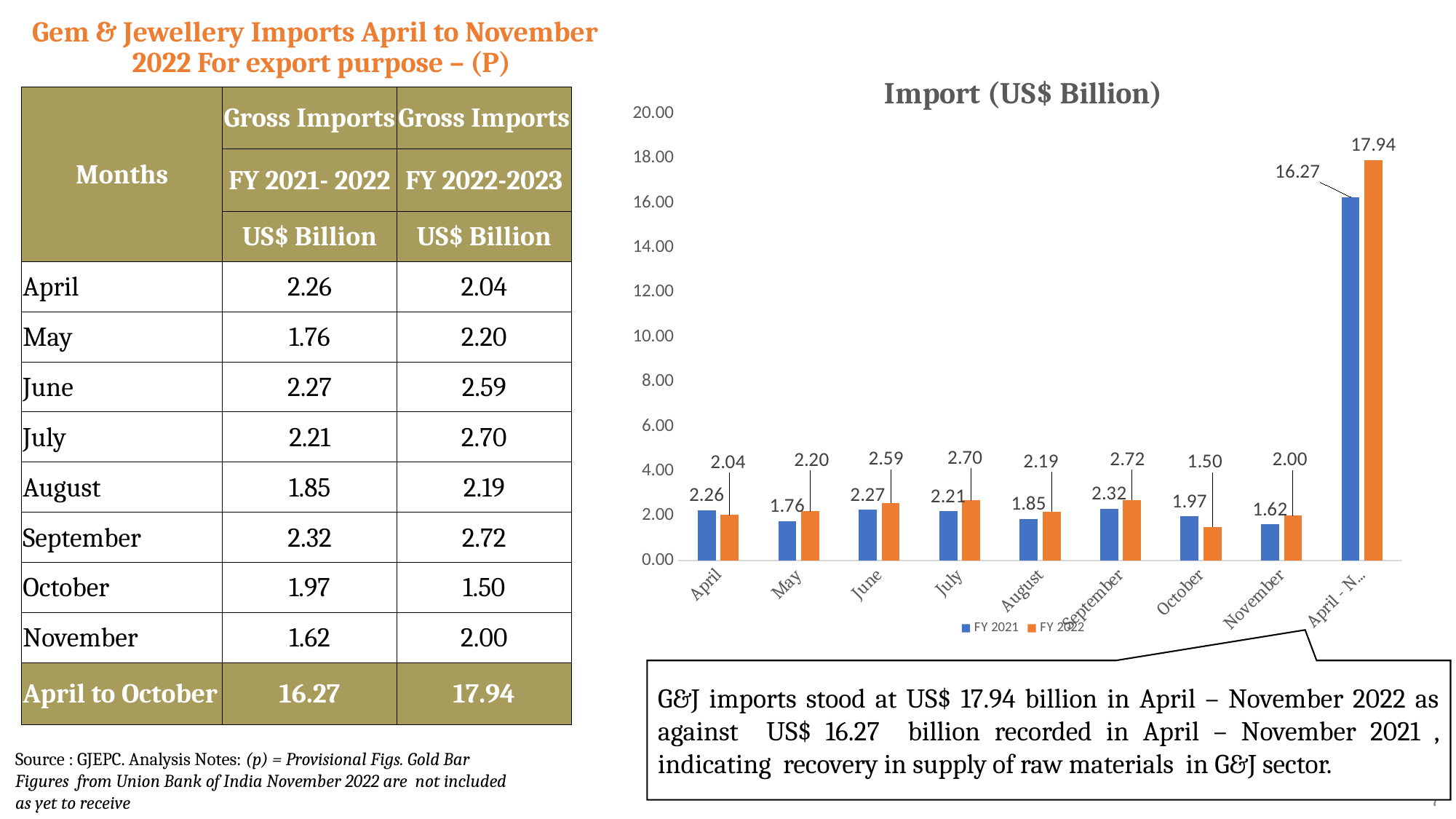
What is the FY 2022 value for October in the Import (US$ Billion) chart? 1.50 Among the individual months, which month has the lowest FY 2021 value in the Import (US$ Billion) chart? November What is the difference between the FY 2022 and FY 2021 values for June in the Import (US$ Billion) chart? 0.32 What colour are the FY 2022 bars in the Import (US$ Billion) chart? Orange How many series does the legend of the Import (US$ Billion) chart list? 2 What type of chart is the Import (US$ Billion) chart? Bar chart Among the individual months, which month has the highest FY 2022 value in the Import (US$ Billion) chart? September What is the FY 2022 value for July in the Import (US$ Billion) chart? 2.70 What is the FY 2021 value for September in the Import (US$ Billion) chart? 2.32 How many categories are shown on the x axis of the Import (US$ Billion) chart? 9 Is the FY 2022 value for the April - November total bar greater or less than 16.00 in the Import (US$ Billion) chart? greater In the Import (US$ Billion) chart, which is larger for October: the FY 2021 value or the FY 2022 value? FY 2021